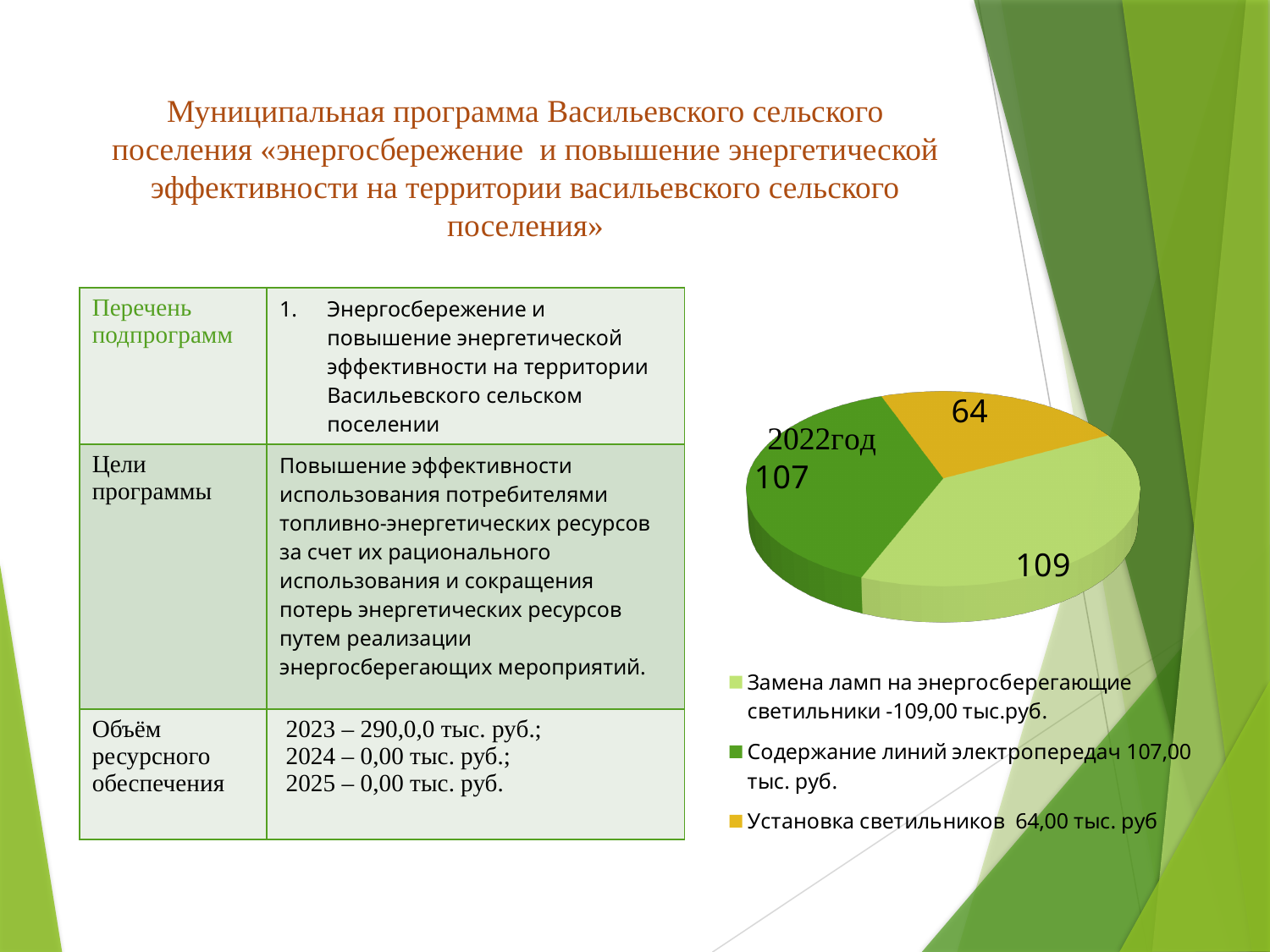
How many entries does the legend of the pie chart list? 3 What value is shown on the pie chart for «Установка светильников»? 64 What year label is printed on the pie chart? 2022год Which category has the smallest slice in the pie chart? Установка светильников What kind of chart is shown on the right side of the slide? pie chart What is the difference between the values for «Замена ламп на энергосберегающие светильники» and «Установка светильников» in the pie chart? 45 Which is larger in the pie chart: the value for «Содержание линий электропередач» or for «Установка светильников»? Содержание линий электропередач What value is shown on the pie chart for «Замена ламп на энергосберегающие светильники»? 109 Which category has the largest slice in the pie chart? Замена ламп на энергосберегающие светильники What value is shown on the pie chart for «Содержание линий электропередач»? 107 What is the total of all three values shown in the pie chart? 280 How many slices does the pie chart have? 3